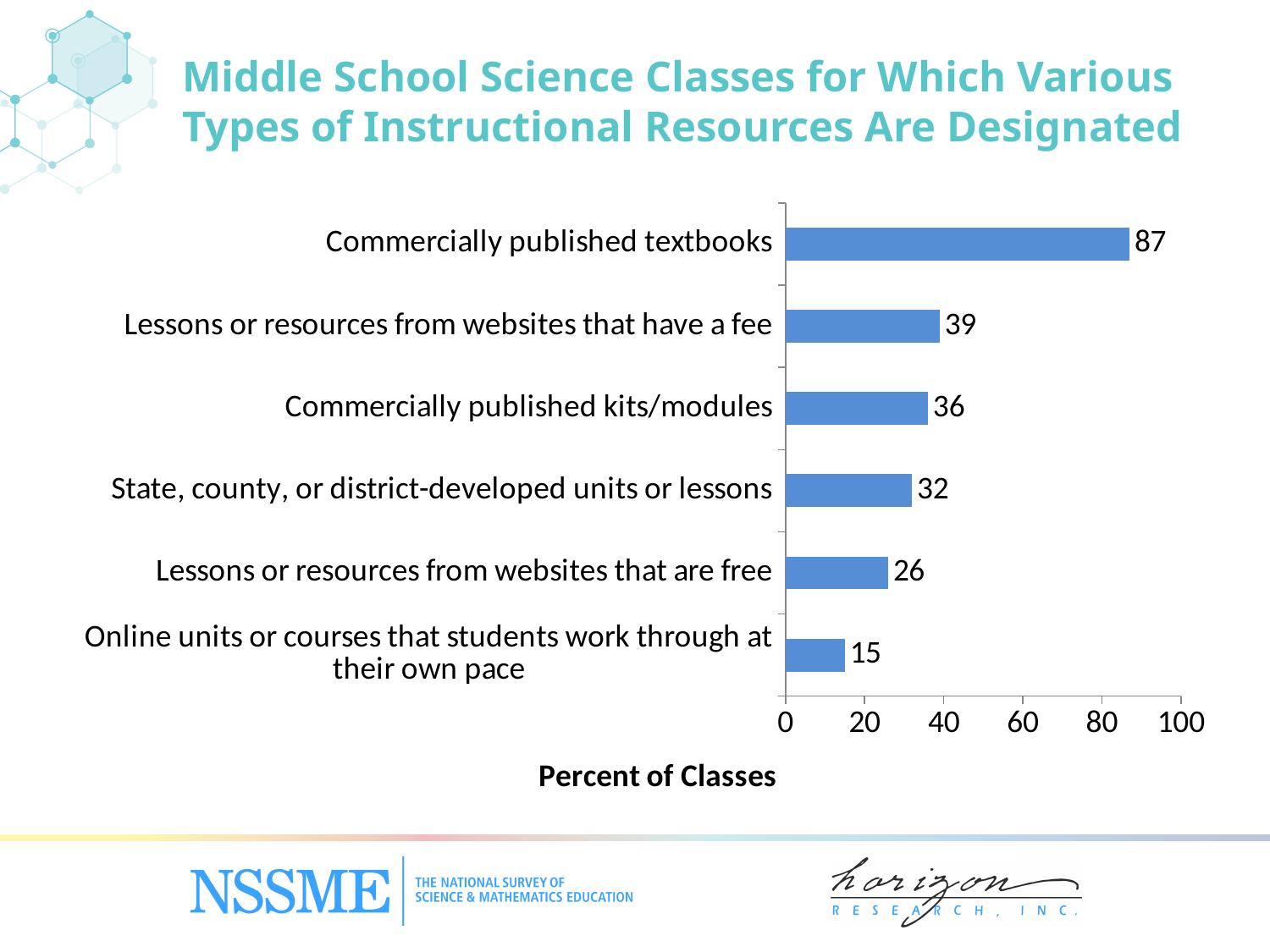
What is the value for commercially published kits/modules? 36 Which is larger: the value for lessons or resources from websites that have a fee or the value for lessons or resources from websites that are free? Lessons or resources from websites that have a fee What kind of chart is shown on the slide? Bar chart What is the value for online units or courses that students work through at their own pace? 15 Which type of instructional resource has the highest percent of classes? Commercially published textbooks What percent of classes have commercially published textbooks designated? 87 What is the value for lessons or resources from websites that have a fee? 39 What is the difference between the values for state, county, or district-developed units or lessons and lessons or resources from websites that are free? 6 Which type of instructional resource has the lowest percent of classes? Online units or courses that students work through at their own pace What is the label of the horizontal axis? Percent of Classes How many types of instructional resources are shown in the chart? 6 What is the difference between the values for commercially published textbooks and lessons or resources from websites that have a fee? 48